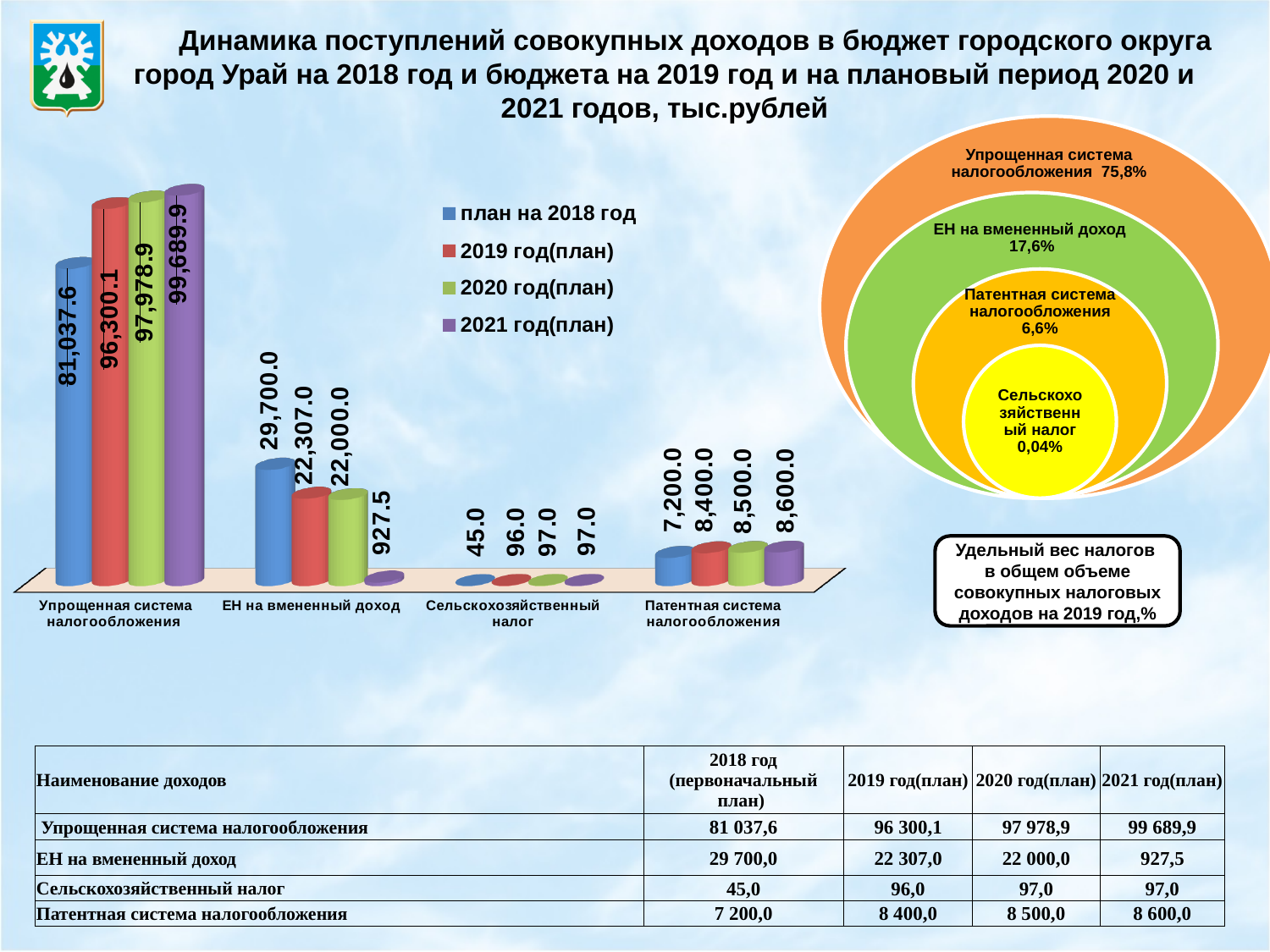
How many categories are shown on the x axis of the bar chart on the left? 4 In the bar chart on the left, what is the value for Патентная система налогообложения in the series 2020 год(план)? 8,500.0 In the bar chart on the left, do the values for Упрощенная система налогообложения rise or fall from план на 2018 год to 2021 год(план)? rise How many series does the legend of the bar chart on the left list? 4 In the bar chart on the left, what is the value for ЕН на вмененный доход in the series 2021 год(план)? 927.5 In the bar chart on the left, what is the value for Упрощенная система налогообложения in the series план на 2018 год? 81,037.6 In the bar chart on the left, what is the difference between the 2019 год(план) and план на 2018 год values for ЕН на вмененный доход? 7,393.0 In the nested circle diagram on the right, what share does ЕН на вмененный доход have in total tax revenues for 2019? 17,6% In the bar chart on the left, which is larger for Патентная система налогообложения: the 2019 год(план) value or the 2021 год(план) value? 2021 год(план) In the bar chart on the left, what is the value for Сельскохозяйственный налог in the series план на 2018 год? 45.0 In the bar chart on the left, which category has the highest value in the series 2021 год(план)? Упрощенная система налогообложения In the bar chart on the left, which category has the lowest value in the series 2019 год(план)? Сельскохозяйственный налог